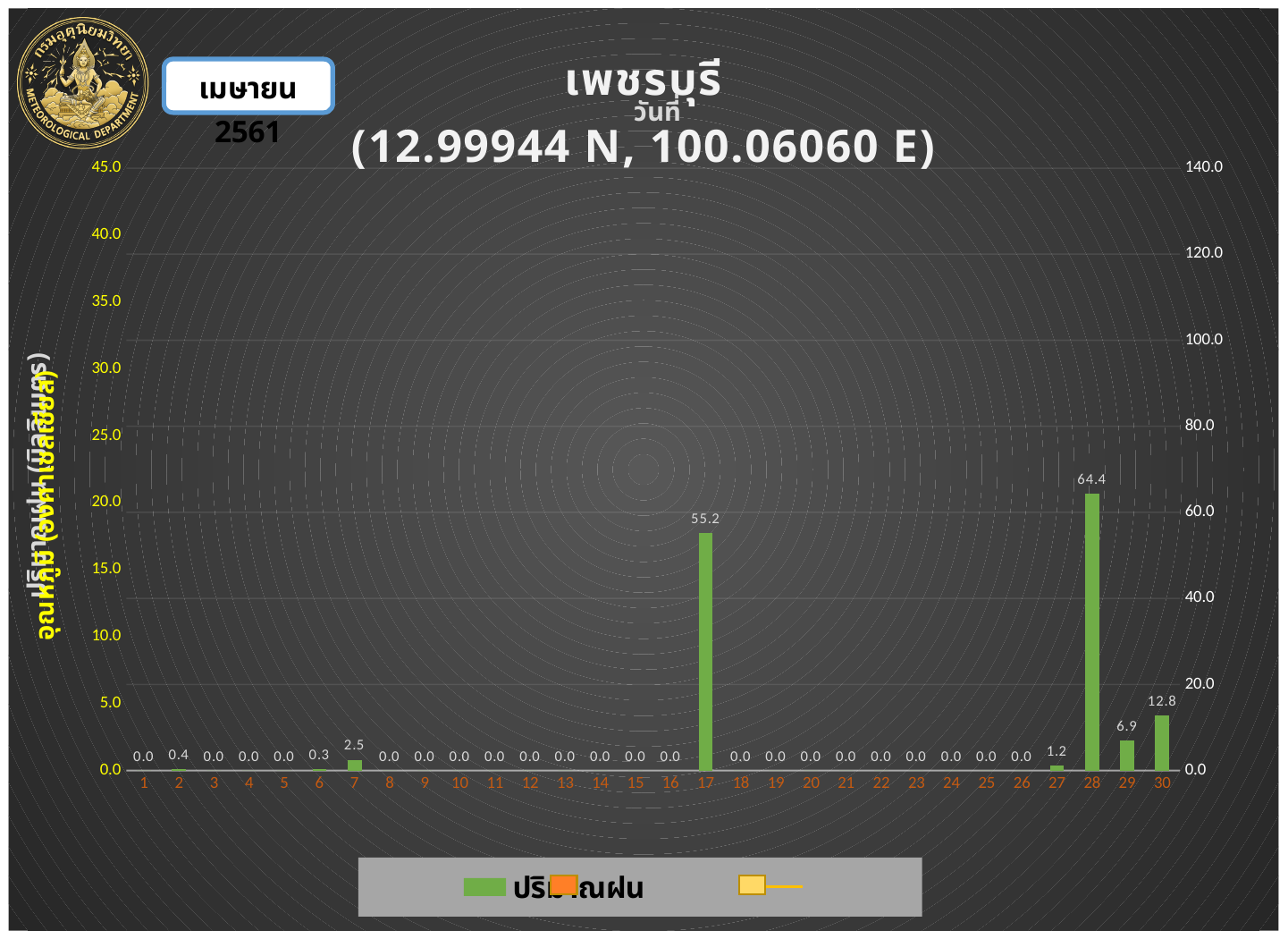
What is the rainfall value for day 28? 64.4 What is the rainfall value for day 17? 55.2 What is the rainfall value for day 29? 6.9 What is the rainfall value for day 30? 12.8 Which day has the highest rainfall value? 28 What are the coordinates shown in the chart title? 12.99944 N, 100.06060 E What kind of chart is shown on the slide? bar chart What is the difference between the rainfall values for day 30 and day 29? 5.9 Which is larger, the rainfall value for day 29 or for day 30? day 30 What is the difference between the rainfall values for day 28 and day 17? 9.2 How many days are shown on the x axis? 30 What is the rainfall value for day 7? 2.5